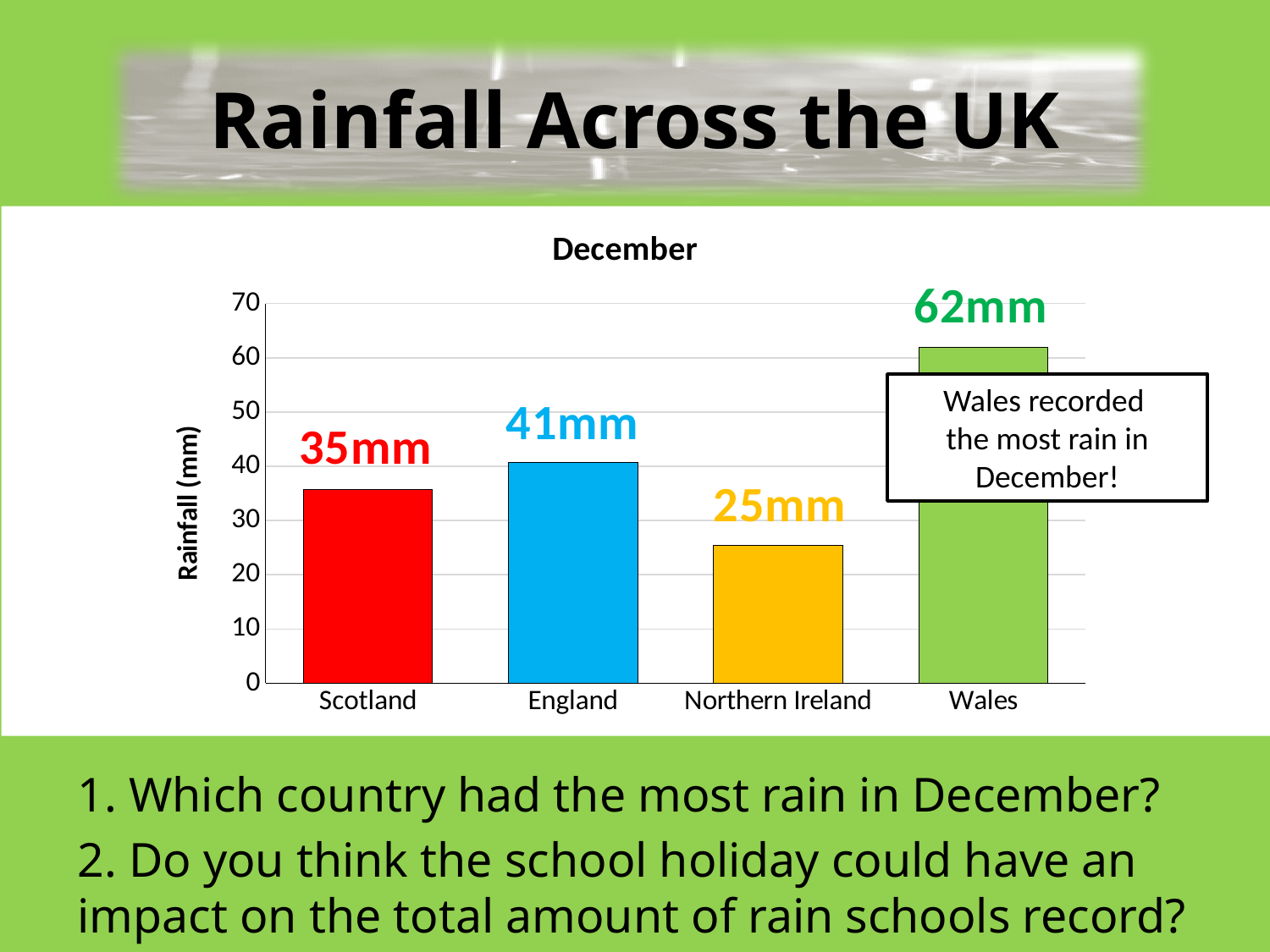
What is the difference in rainfall between Wales and Northern Ireland? 37mm What is the rainfall value for Northern Ireland? 25mm What is the title of the chart? December Which has more rainfall, Scotland or England? England Which country has the lowest rainfall in the chart? Northern Ireland What is the rainfall value for England? 41mm What is the difference in rainfall between England and Scotland? 6mm How many countries are shown in the chart? 4 What kind of chart is shown on the slide? Bar chart Which country has the highest rainfall in the chart? Wales What is the rainfall value for Wales? 62mm What is the rainfall value for Scotland? 35mm